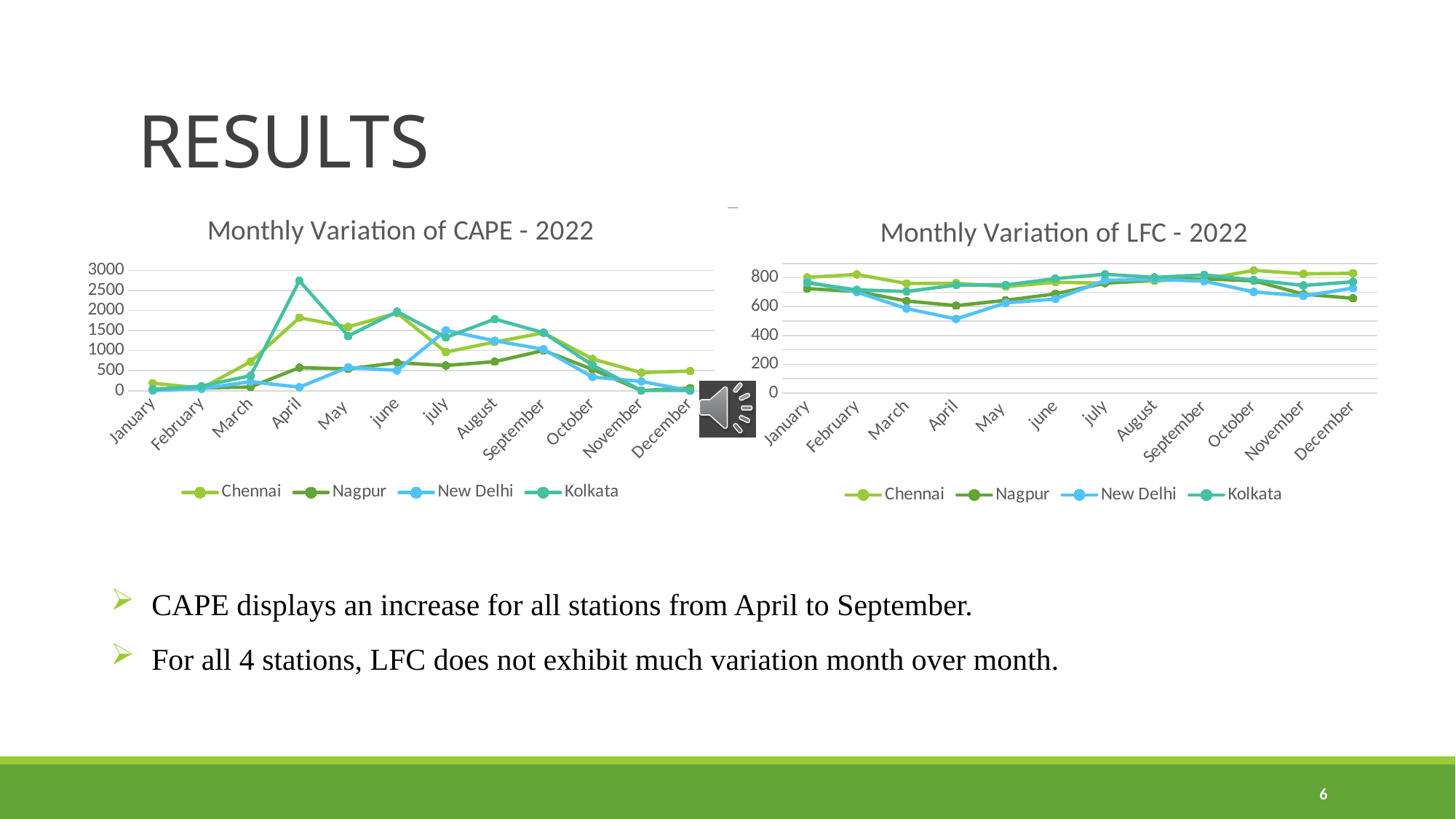
In the 'Monthly Variation of CAPE - 2022' chart, is the value for New Delhi in April greater or less than 500? less How many series does the legend of the 'Monthly Variation of LFC - 2022' chart list? 4 In the 'Monthly Variation of CAPE - 2022' chart, is the value for Kolkata in April greater or less than 2500? greater In the 'Monthly Variation of LFC - 2022' chart, is the value for New Delhi in April greater or less than 600? less In the 'Monthly Variation of CAPE - 2022' chart, which station has the lowest value in April? New Delhi What kind of chart is the 'Monthly Variation of CAPE - 2022' chart? line chart What is the title of the chart on the right side of the slide? Monthly Variation of LFC - 2022 In the 'Monthly Variation of CAPE - 2022' chart, does the Kolkata line rise or fall from April to May? fall In the 'Monthly Variation of LFC - 2022' chart, does the New Delhi line rise or fall from February to April? fall In the 'Monthly Variation of CAPE - 2022' chart, which station has the highest value in April? Kolkata How many months are shown on the x axis of the 'Monthly Variation of CAPE - 2022' chart? 12 In the 'Monthly Variation of LFC - 2022' chart, which station has the lowest value in April? New Delhi